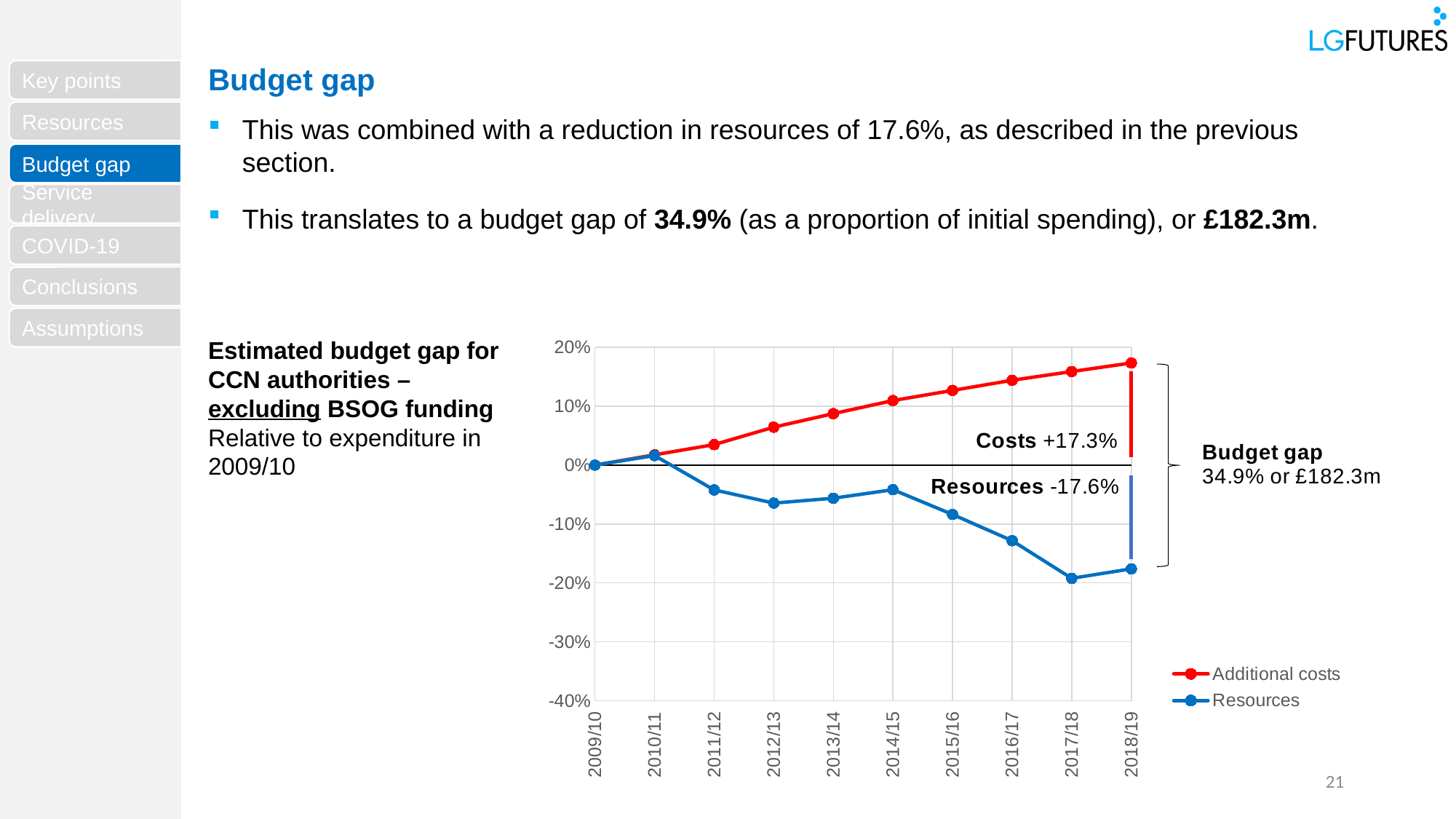
What budget gap is annotated to the right of the chart? 34.9% or £182.3m Does the Resources series rise or fall from 2010/11 to 2017/18? fall What is the value of the Resources series in 2018/19, as annotated on the chart? -17.6% Is the value for Additional costs in 2015/16 greater or less than 10%? greater Does the Additional costs series rise or fall from 2009/10 to 2018/19? rise In which year does the Resources series reach its lowest value? 2017/18 In 2018/19, which series has the larger value: Additional costs or Resources? Additional costs How many years are plotted along the x axis of the chart? 10 Is the value for Resources in 2017/18 greater or less than -10%? less How many series does the chart legend list? 2 What is the value of the Additional costs series in 2018/19, as annotated on the chart? +17.3% What type of chart is shown on the slide? line chart